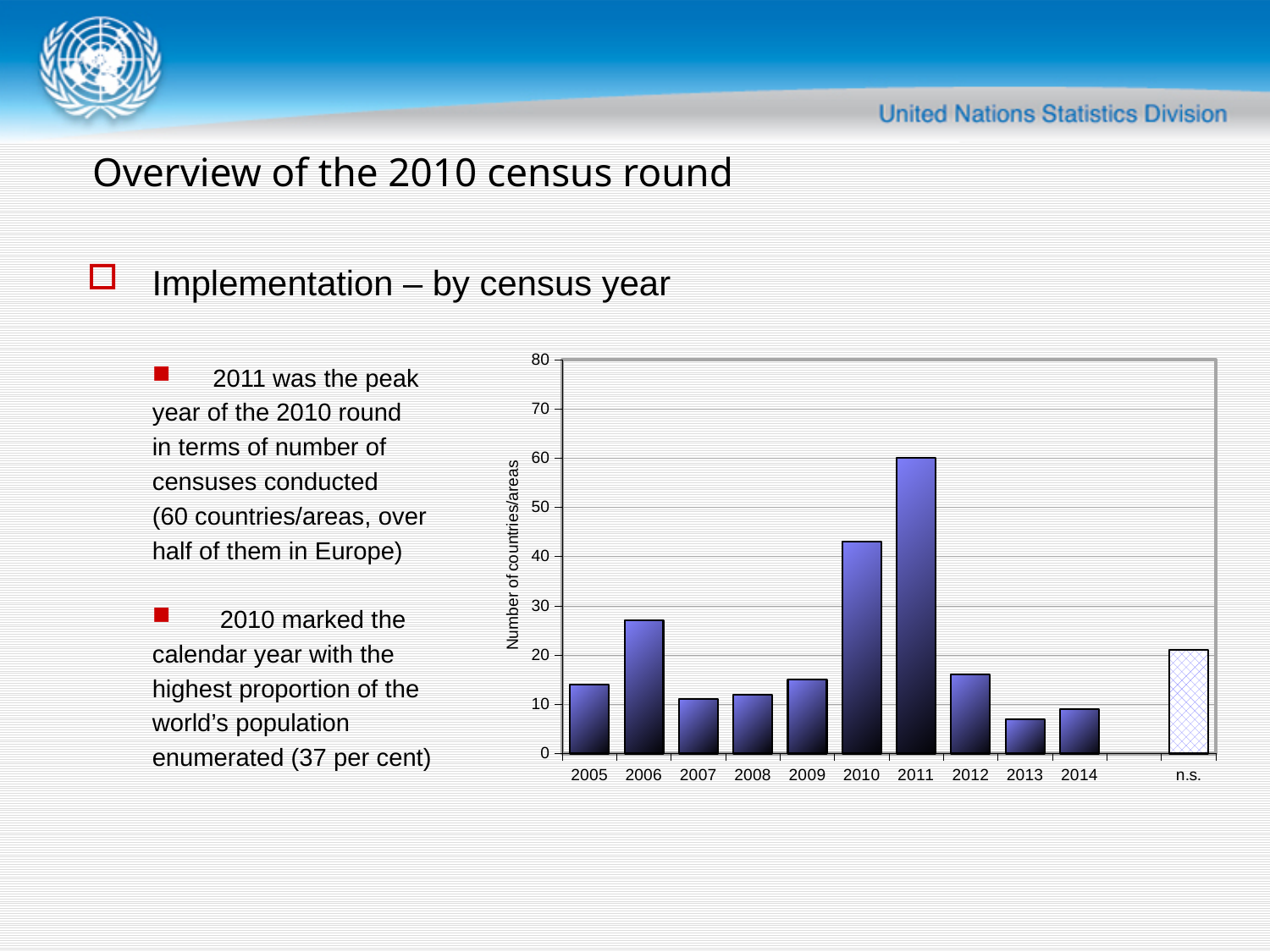
Which has a larger value, 2010 or 2006? 2010 How many countries/areas conducted a census in 2011 according to the chart? 60 How many categories are shown on the x axis of the chart? 11 Is the value for 2006 greater or less than 30? less Is the value for n.s. greater or less than 30? less Is the value for 2013 greater or less than 10? less Which census year has the highest number of countries/areas? 2011 Which census year has the lowest number of countries/areas? 2013 Which has a larger value, 2009 or 2012? 2012 What is the label of the vertical axis of the chart? Number of countries/areas What type of chart is shown on the slide? bar chart